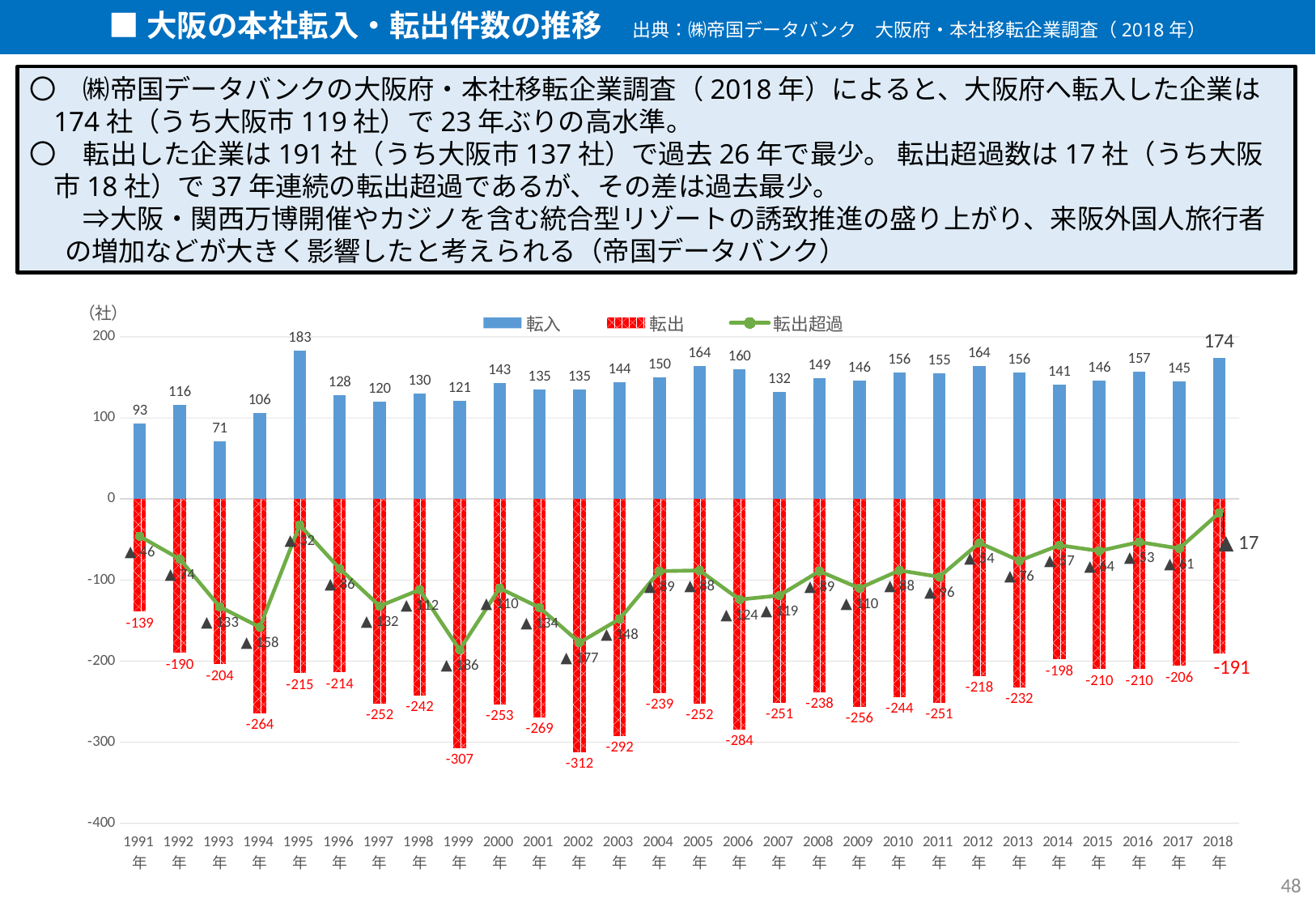
What is the 転出 value for 2002年? -312 What is the 転出 value for 1991年? -139 Which is larger in absolute terms, the 転出 value for 1999年 or for 2003年? 1999年 Which series is drawn as a green line? 転出超過 What is the difference between the 転入 values for 2018年 and 2017年? 29 What is the 転入 value for 2018年? 174 Which year has the highest 転入 value? 1995年 How many years are shown on the x axis? 28 What is the 転入 value for 1995年? 183 How many series does the legend list? 3 Which year has the lowest 転入 value? 1993年 What kind of chart is shown on the slide? Combined bar and line chart